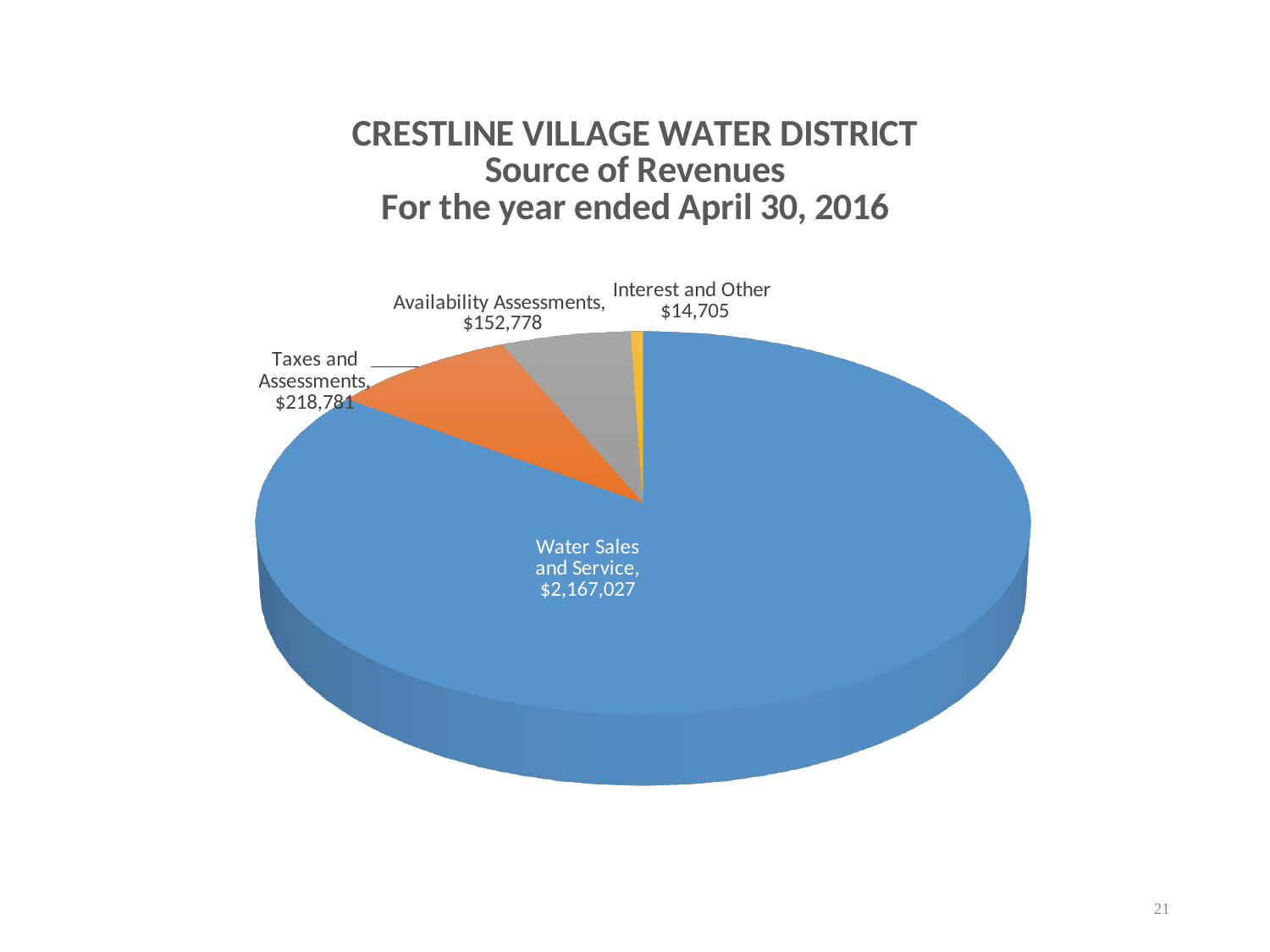
What is the value for Availability Assessments? $152,778 What is the difference between Taxes and Assessments and Availability Assessments? $66,003 How many slices does the pie chart have? 4 What is the value for Taxes and Assessments? $218,781 For which year-end period does the chart show the source of revenues? For the year ended April 30, 2016 What type of chart is shown on the slide? Pie chart Which revenue source is the smallest? Interest and Other What is the value for Water Sales and Service? $2,167,027 Which revenue source is the largest? Water Sales and Service What is the total of all revenue sources shown in the pie chart? $2,553,291 What is the value for Interest and Other? $14,705 Which is larger, Taxes and Assessments or Availability Assessments? Taxes and Assessments